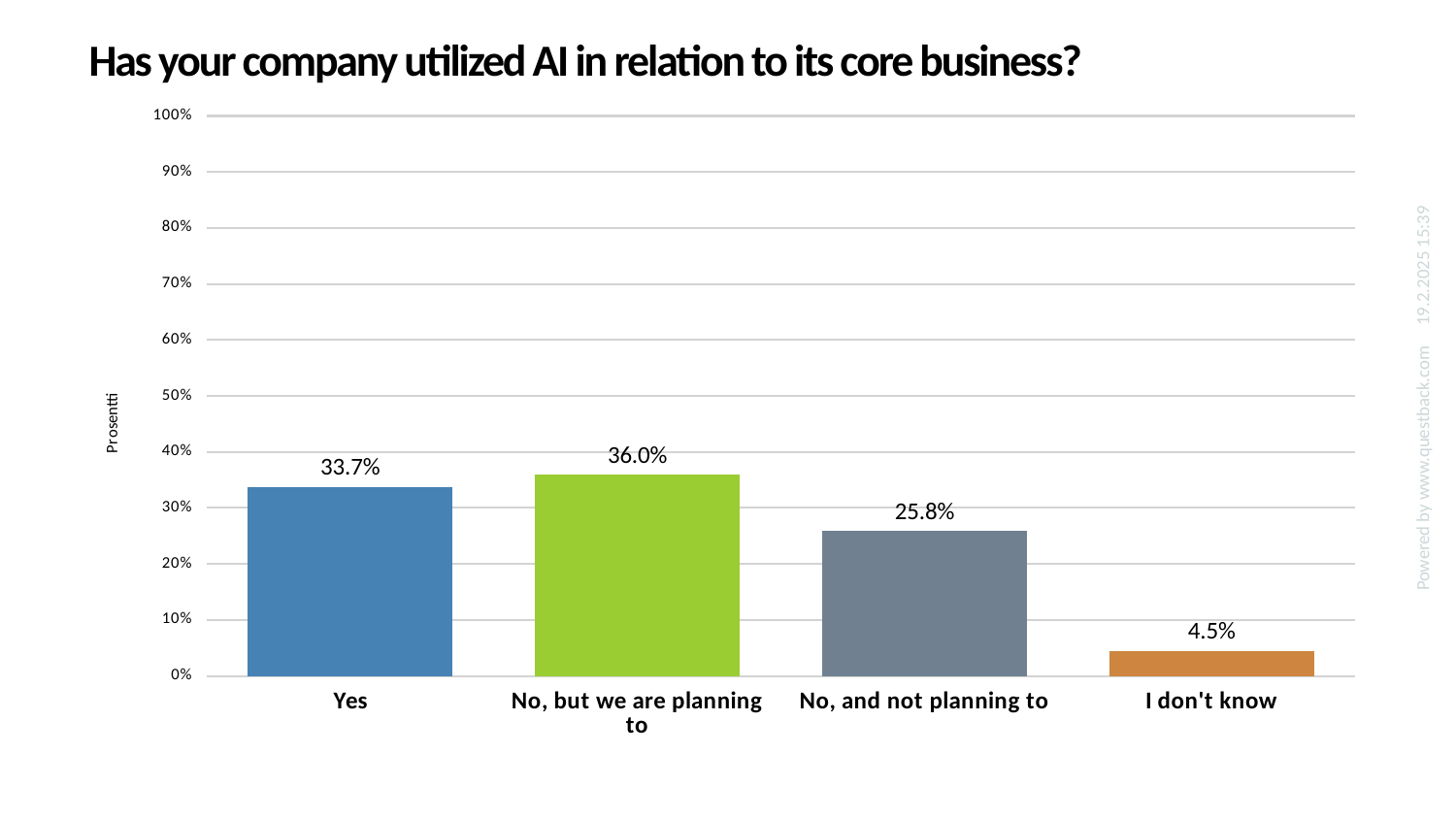
What is the difference in percentage points between "No, but we are planning to" and "Yes"? 2.3 What is the value for "No, but we are planning to"? 36.0% Which response category has the highest value? No, but we are planning to What percentage of respondents answered "Yes"? 33.7% What percentage of respondents answered "I don't know"? 4.5% What is the value for "No, and not planning to"? 25.8% What type of chart is shown on the slide? Bar chart Which is larger, the value for "Yes" or the value for "No, and not planning to"? Yes How many response categories are shown on the chart? 4 What is the title of the chart? Has your company utilized AI in relation to its core business? Which response category has the lowest value? I don't know Is the value for "No, and not planning to" greater or less than 30%? less